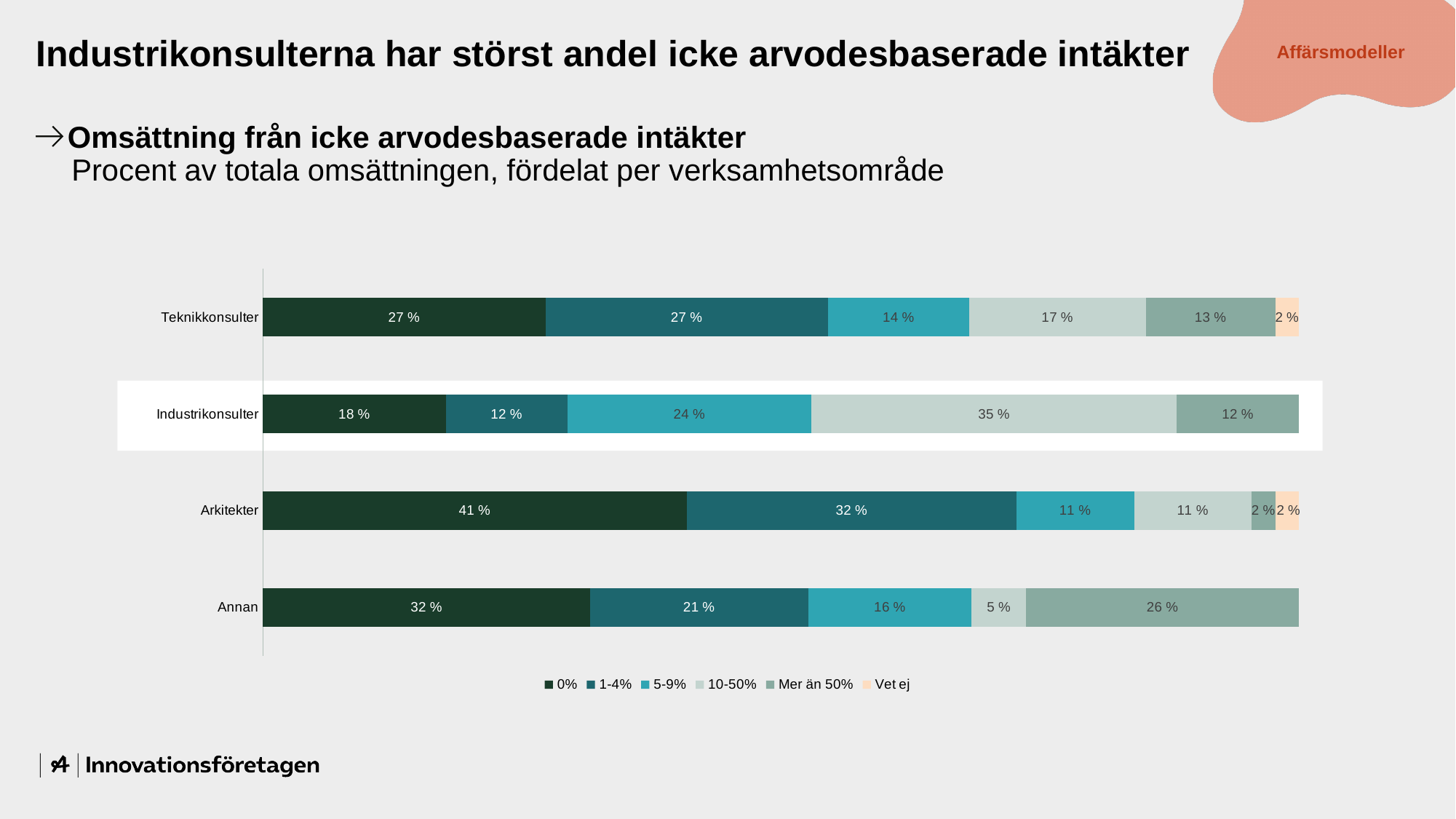
Which category has the highest value for the '0%' series? Arkitekter Which is larger: the '1-4%' value for Teknikkonsulter or for Annan? Teknikkonsulter What is the value of the '0%' series for Arkitekter? 41 % What is the value of the 'Mer än 50%' series for Annan? 26 % How many series does the legend list? 6 What is the value of the '5-9%' series for Teknikkonsulter? 14 % What is the title of the chart? Omsättning från icke arvodesbaserade intäkter What kind of chart is shown on the slide? Stacked bar chart How many categories (verksamhetsområden) are shown on the chart? 4 What is the difference between the '0%' values for Arkitekter and Industrikonsulter? 23 % Which category has the lowest value for the '10-50%' series? Annan What is the value of the '10-50%' series for Industrikonsulter? 35 %